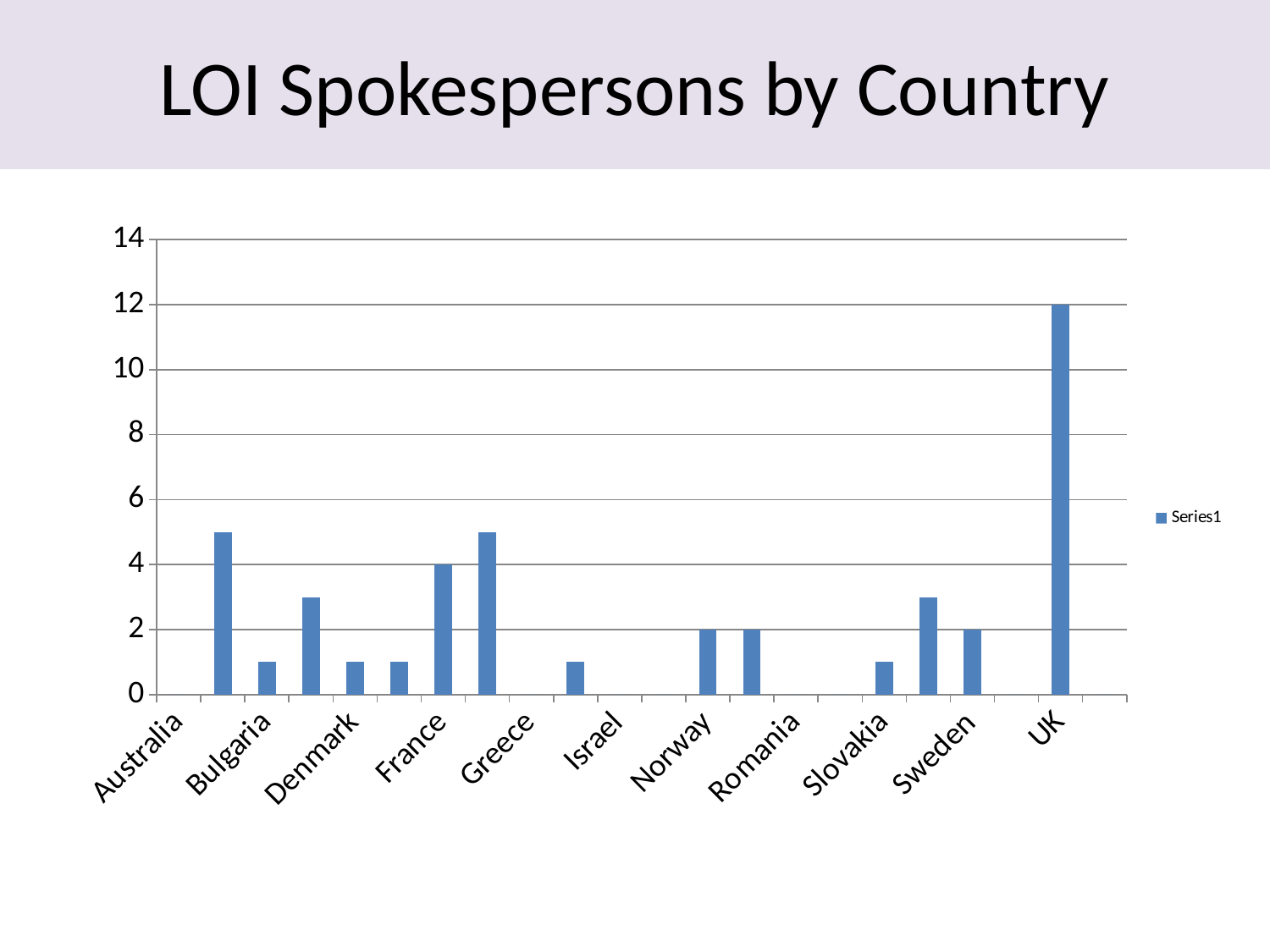
What kind of chart is shown on the slide? bar chart What is the value for Norway? 2 Is the value for Bulgaria greater or less than 2? less What is the title of the slide? LOI Spokespersons by Country What is the value for UK? 12 Is the value for UK greater or less than 10? greater Which country has the highest value? UK What is the value for Sweden? 2 What is the difference between the values for UK and France? 8 How many series does the legend list? 1 What is the value for France? 4 Which is larger, the value for France or the value for Norway? France